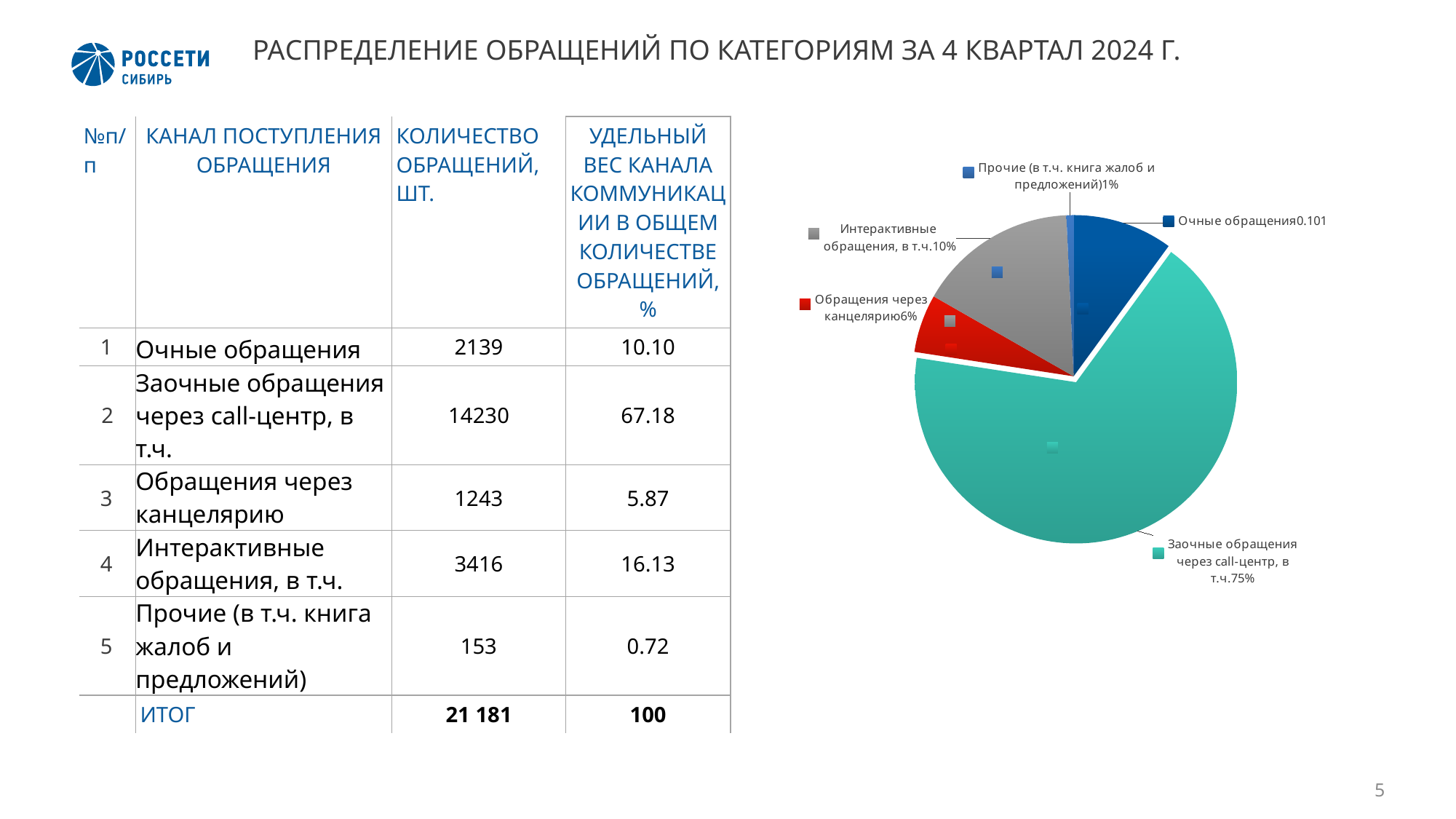
What value is printed next to the slice "Очные обращения" in the pie chart? 0.101 What share is labelled for the slice "Прочие (в т.ч. книга жалоб и предложений)" in the pie chart? 1% What share is labelled for the slice "Интерактивные обращения, в т.ч." in the pie chart? 10% What share is labelled for the slice "Заочные обращения через call-центр, в т.ч." in the pie chart? 75% In the pie chart, which slice is larger: "Интерактивные обращения, в т.ч." or "Обращения через канцелярию"? Интерактивные обращения, в т.ч. Which slice of the pie chart is the largest? Заочные обращения через call-центр, в т.ч. What kind of chart is shown on the slide? Pie chart How many slices does the pie chart have? 5 What colour is the largest slice of the pie chart? Teal Which slice of the pie chart is the smallest? Прочие (в т.ч. книга жалоб и предложений) By how many percentage points does the labelled share of "Интерактивные обращения, в т.ч." exceed that of "Обращения через канцелярию" in the pie chart? 4